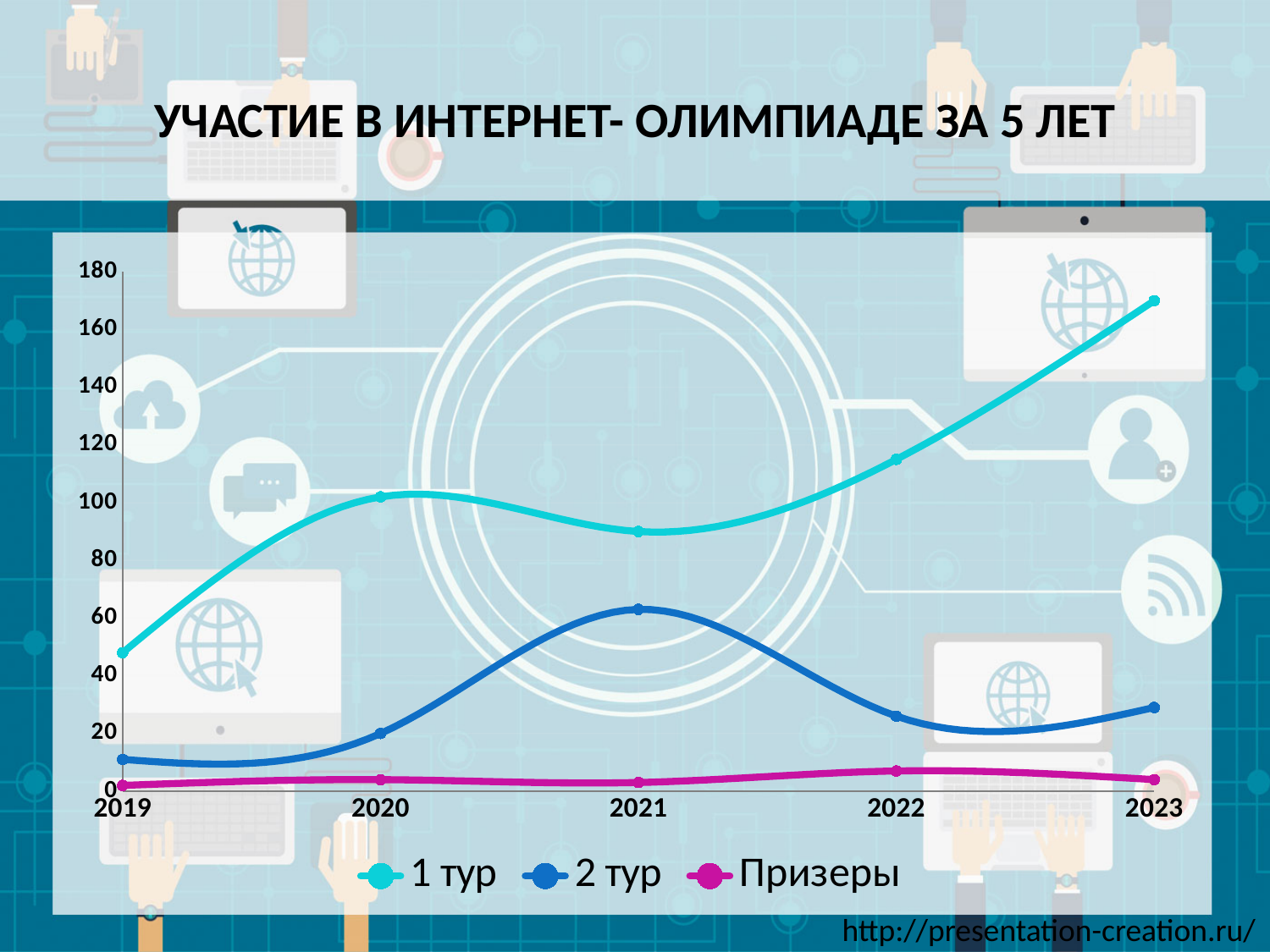
Is the value for "2 тур" in 2021 greater or less than 80? less Is the value for "1 тур" in 2023 greater or less than 160? greater In which year is the value for "1 тур" lowest? 2019 How many years are plotted along the x axis? 5 Is the value for "1 тур" in 2019 greater or less than 60? less In which year is the value for "2 тур" highest? 2021 What is the title of the chart? УЧАСТИЕ В ИНТЕРНЕТ- ОЛИМПИАДЕ ЗА 5 ЛЕТ In which year is the value for "1 тур" highest? 2023 Does the value for "1 тур" rise or fall from 2021 to 2023? rise What kind of chart is shown on the slide? line chart Which series has the larger value in 2022, "1 тур" or "2 тур"? 1 тур How many series does the legend list? 3